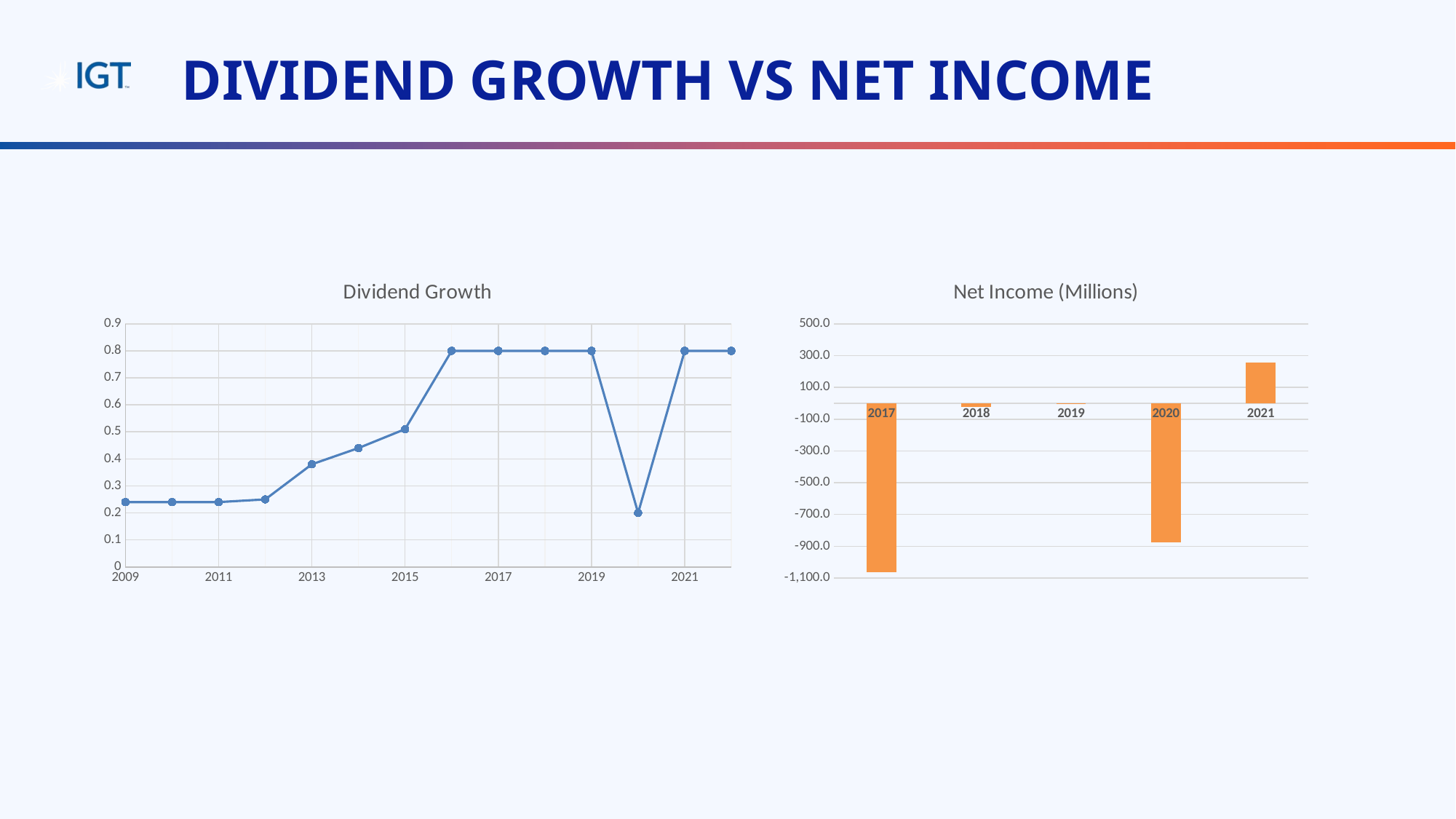
In the Dividend Growth chart, what is the value for 2020? 0.2 In the Dividend Growth chart, which year has the lowest value? 2020 What kind of chart is the Dividend Growth chart? line chart In the Dividend Growth chart, which is larger, the value for 2013 or the value for 2015? 2015 In the Dividend Growth chart, is the value for 2013 greater or less than 0.4? less In the Dividend Growth chart, what is the value for 2017? 0.8 What kind of chart is the Net Income (Millions) chart? bar chart How many years are shown in the Net Income (Millions) chart? 5 In the Net Income (Millions) chart, which year has the highest value? 2021 In the Net Income (Millions) chart, which year has the lowest value? 2017 In the Net Income (Millions) chart, is the value for 2021 greater or less than 100.0? greater In the Dividend Growth chart, do the values rise or fall from 2012 to 2016? rise